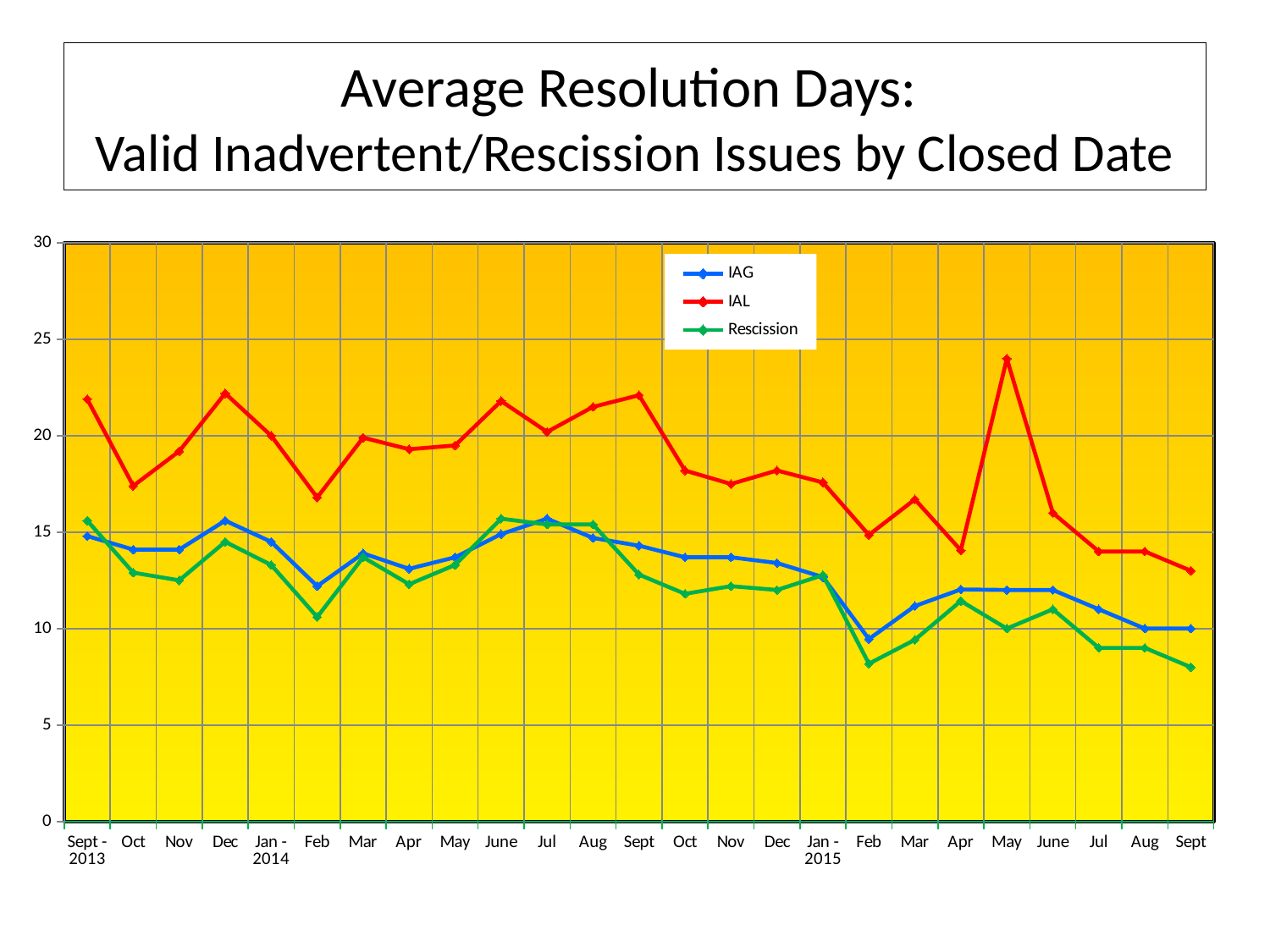
Is the Rescission value for Feb 2015 greater or less than 10? less How many series does the legend list? 3 Is the Rescission value for Sept 2015 greater or less than 10? less In which month does the IAL series reach its highest value? May 2015 Is the IAL value for Dec 2013 greater or less than 20? greater Which series has the larger value in Sept 2013, IAL or IAG? IAL Does the IAL series rise or fall from June 2015 to Sept 2015? fall What is the title of the chart? Average Resolution Days: Valid Inadvertent/Rescission Issues by Closed Date How many months (data points) are plotted along the x axis? 25 What kind of chart is shown on the slide? line chart Which series is drawn in red? IAL